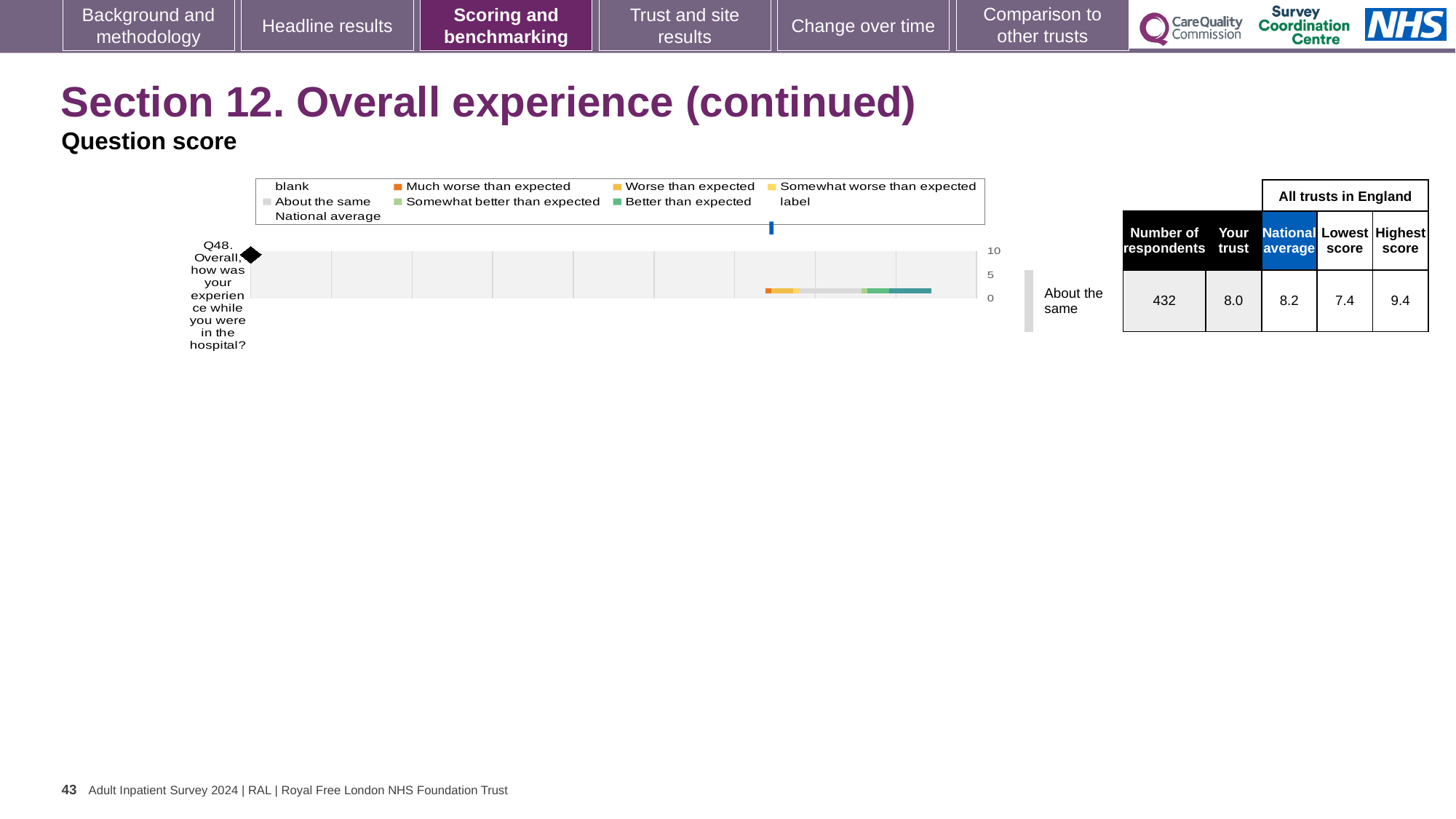
What is the difference between the highest score and the lowest score for Q48? 2.0 What is the national average score for Q48? 8.2 What is the highest score among all trusts in England for Q48? 9.4 What is the 'Your trust' score for Q48? 8.0 Which is larger for Q48, the 'Your trust' score or the national average? National average What is the highest tick value shown on the chart's axis? 10 How many entries does the chart legend list? 9 How many respondents answered Q48? 432 Which benchmark category is the trust's result for Q48 labelled as? About the same How many survey questions are plotted in the chart? 1 What kind of chart is shown for Q48? bar chart What is the lowest score among all trusts in England for Q48? 7.4